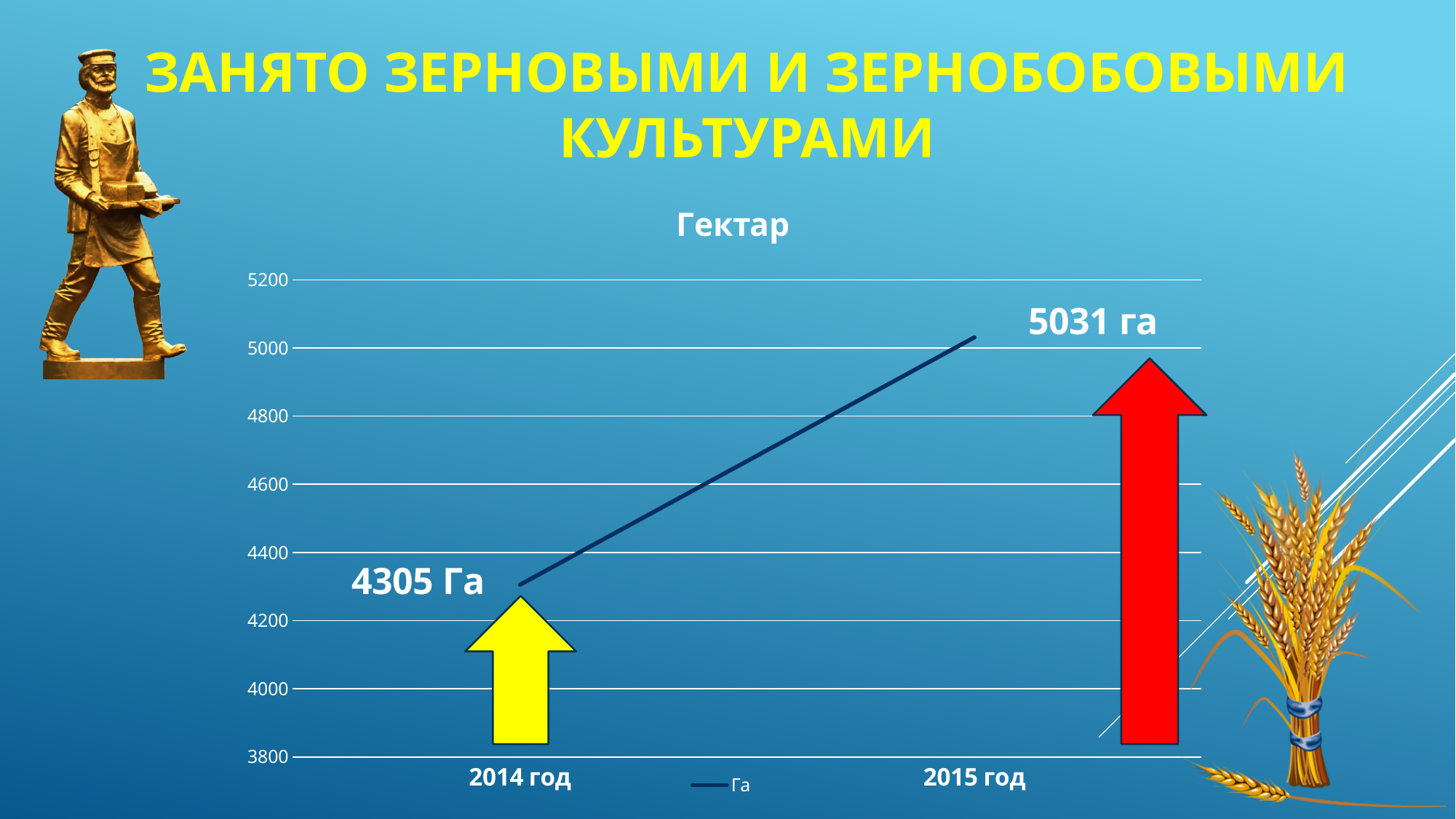
What is the difference between the values for 2015 год and 2014 год? 726 Is the value for 2014 год larger or smaller than the value for 2015 год? smaller Is the value for 2015 год greater or less than 5000? greater What kind of chart is shown on the slide? line chart Is the value for 2014 год greater or less than 4400? less Does the value rise or fall from 2014 год to 2015 год? rise Which year has the lower value? 2014 год How many series does the legend list? 1 How many data points are plotted on the chart? 2 Which year has the higher value? 2015 год What is the value for 2014 год? 4305 Га What is the value for 2015 год? 5031 га